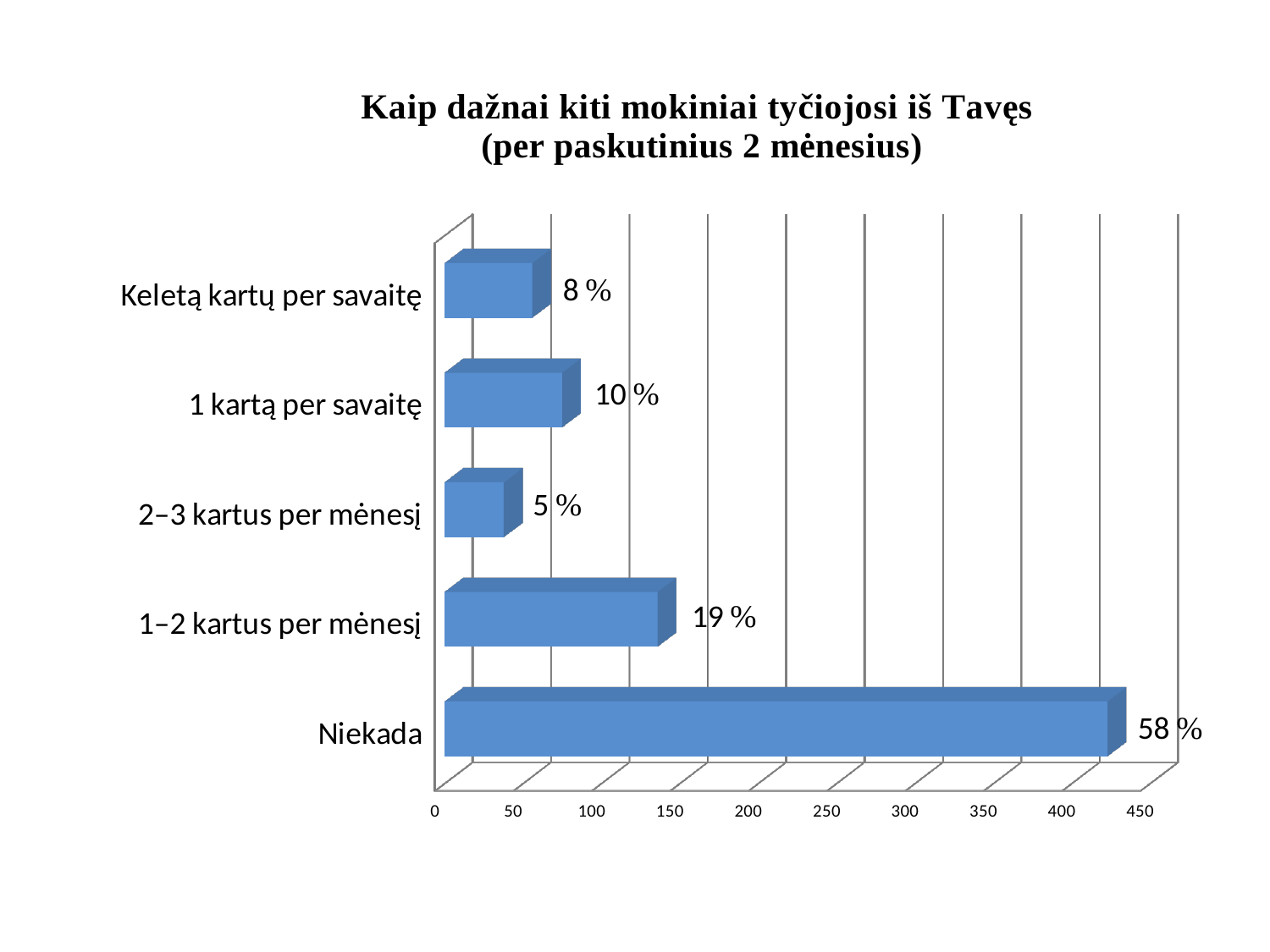
What kind of chart is shown on the slide? bar chart Which category has the highest value? Niekada Is the bar for "Niekada" greater or less than 400 on the axis? greater What is the data label shown for "Niekada"? 58 % What is the data label shown for "2–3 kartus per mėnesį"? 5 % What is the data label shown for "Keletą kartų per savaitę"? 8 % What is the data label shown for "1 kartą per savaitę"? 10 % How many categories are shown in the chart? 5 Which is larger, the value for "1 kartą per savaitę" or the value for "Keletą kartų per savaitę"? 1 kartą per savaitę What is the title of the chart? Kaip dažnai kiti mokiniai tyčiojosi iš Tavęs (per paskutinius 2 mėnesius) Which category has the lowest value? 2–3 kartus per mėnesį What is the data label shown for "1–2 kartus per mėnesį"? 19 %